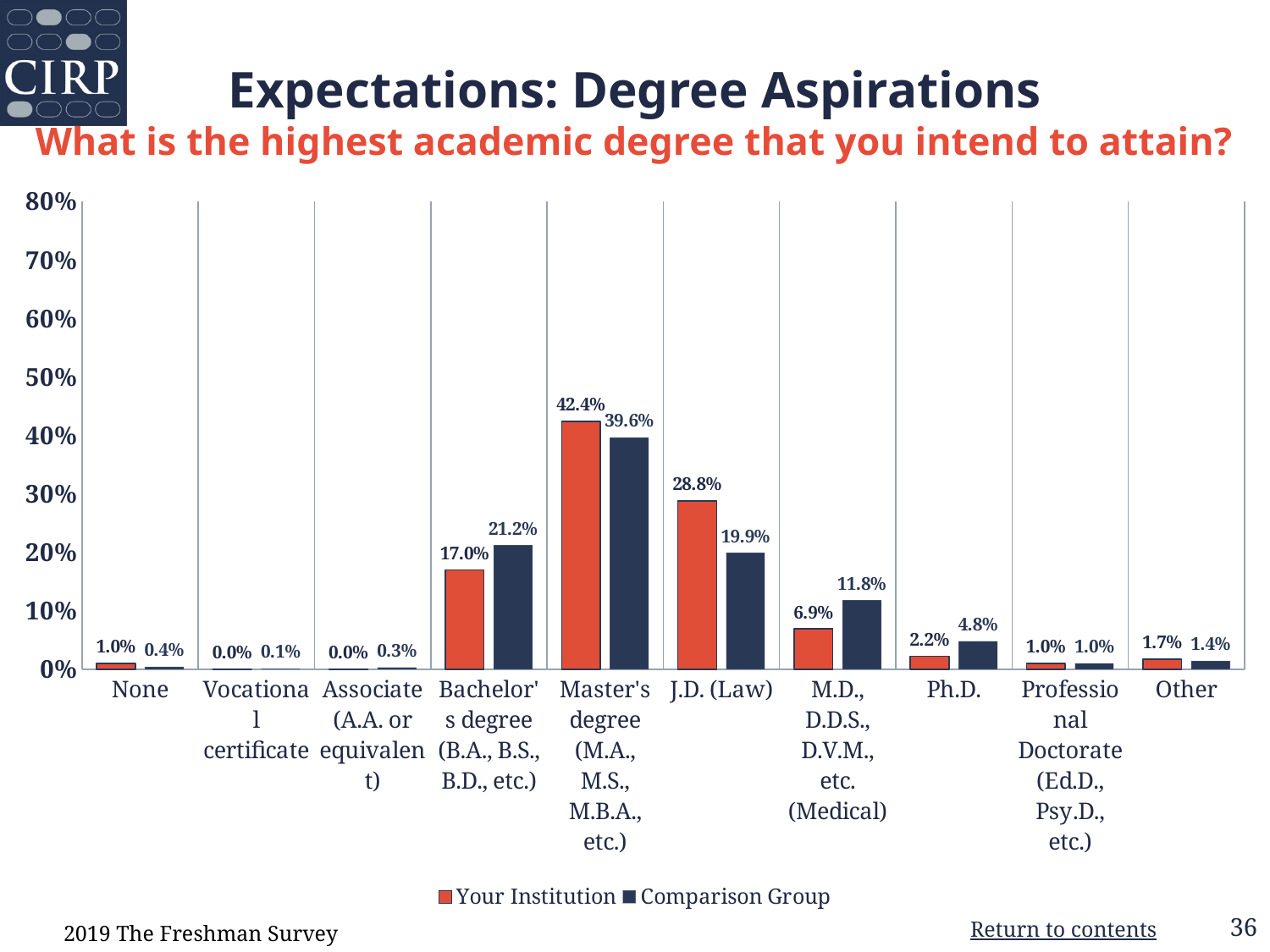
Which is larger for M.D., D.D.S., D.V.M., etc. (Medical): Your Institution or Comparison Group? Comparison Group Is the value for Your Institution for Master's degree greater or less than 40%? greater How many series does the legend list? 2 What is the value for Your Institution for Bachelor's degree? 17.0% How many categories are shown on the x axis? 10 What kind of chart is shown on the slide? bar chart What is the difference between Your Institution and Comparison Group for J.D. (Law)? 8.9% What is the value for Your Institution for Master's degree? 42.4% Which category has the lowest value for Comparison Group? Vocational certificate Which category has the highest value for Your Institution? Master's degree What is the value for Comparison Group for J.D. (Law)? 19.9% What is the value for Comparison Group for Ph.D.? 4.8%